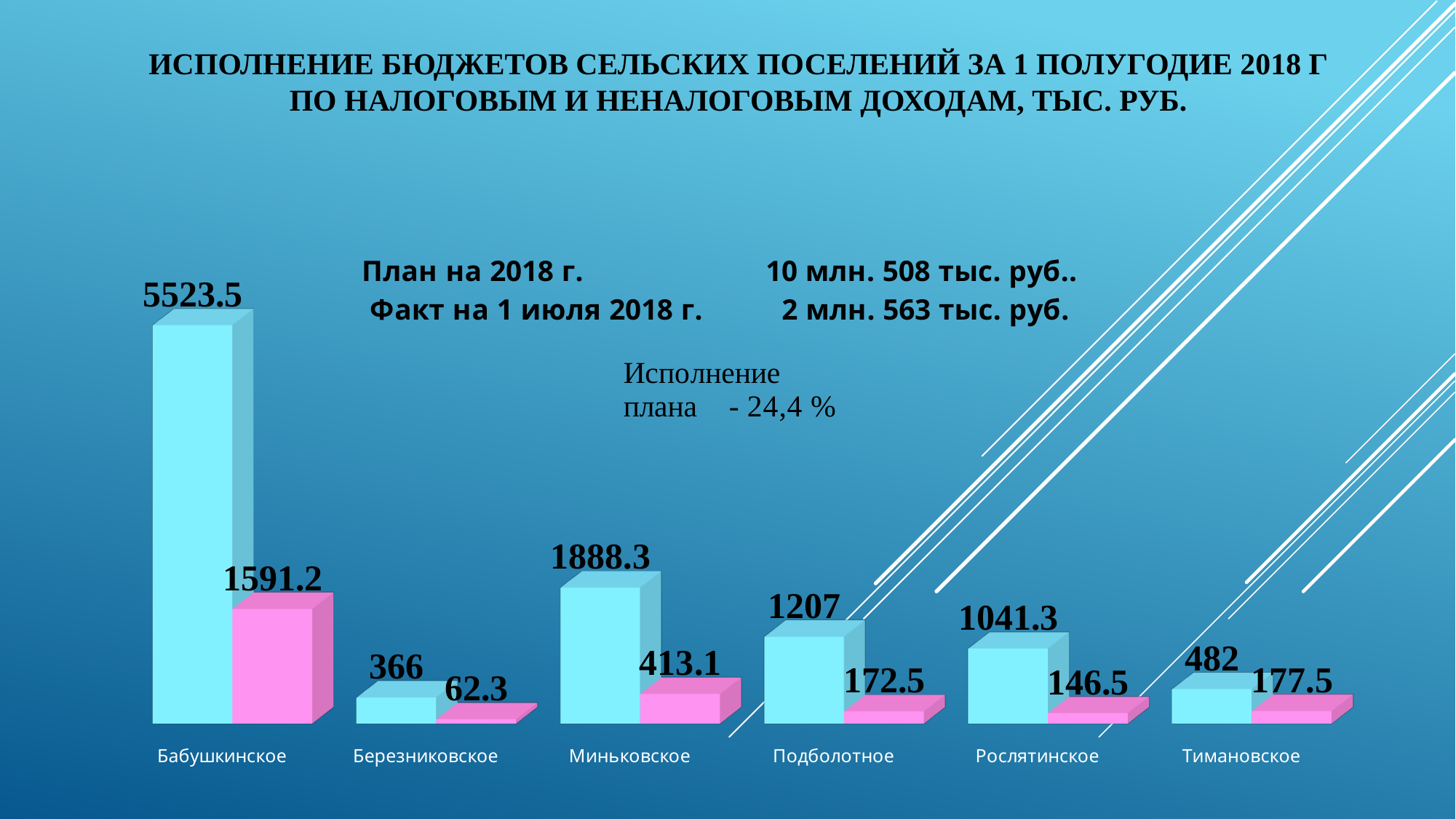
What is the value of the light blue bar for Рослятинское? 1041.3 What is the value of the pink bar for Тимановское? 177.5 Which is larger: the light blue bar for Тимановское or the light blue bar for Березниковское? Тимановское What is the value of the pink bar for Миньковское? 413.1 What kind of chart is shown on the slide? Bar chart Which category has the lowest pink bar? Березниковское How many categories are shown on the x axis of the chart? 6 What percentage of plan execution (Исполнение плана) is stated on the slide? 24,4 % What is the difference between the light blue and pink bars for Подболотное? 1034.5 What is the difference between the light blue and pink bars for Бабушкинское? 3932.3 What is the value of the light blue bar for Бабушкинское? 5523.5 Which category has the highest light blue bar? Бабушкинское